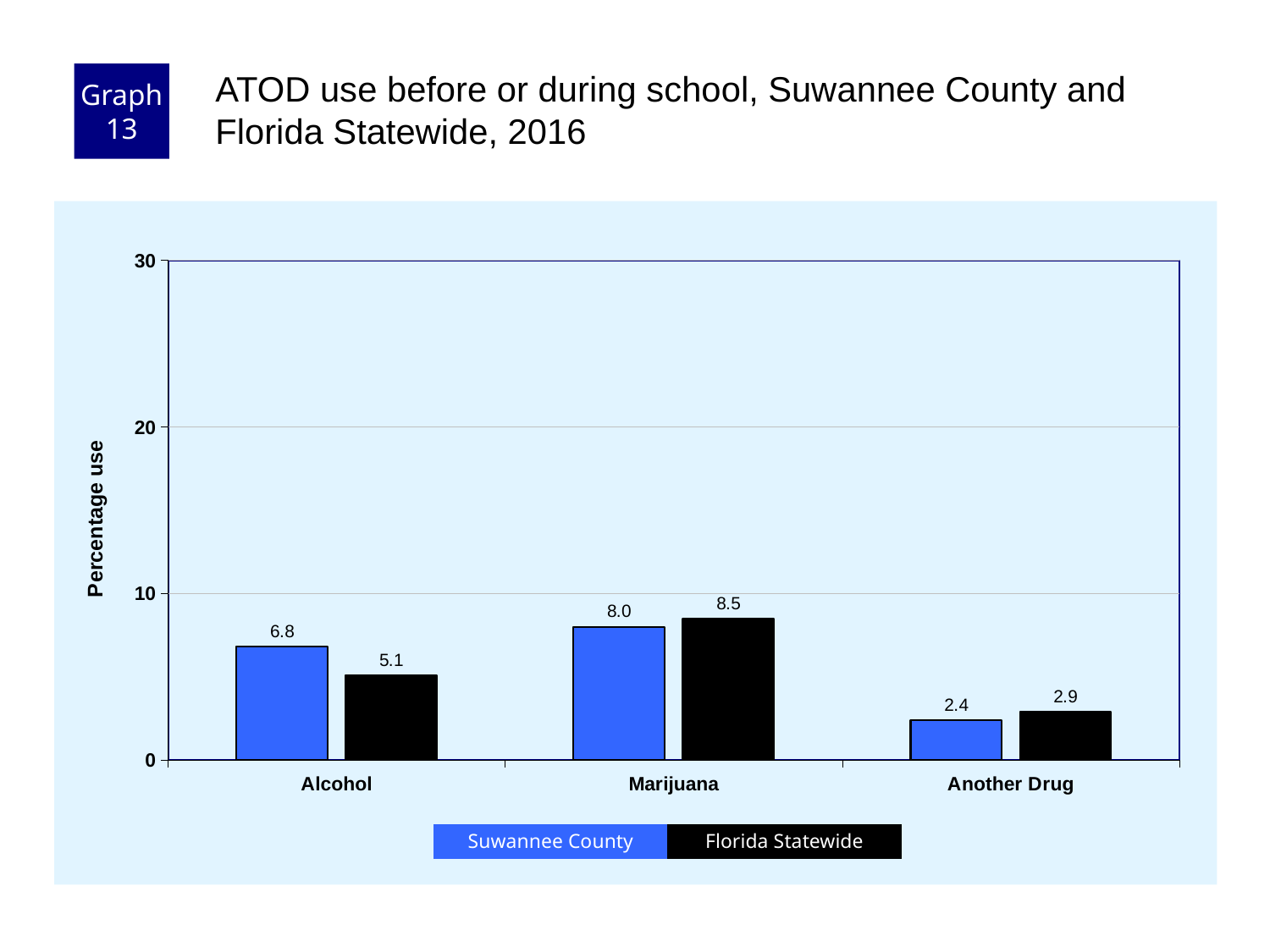
What is the label of the y axis? Percentage use Which category has the highest Florida Statewide value? Marijuana What is the Florida Statewide value for Marijuana? 8.5 How many categories are shown on the x axis? 3 Which category has the lowest Suwannee County value? Another Drug What is the difference between the Suwannee County and Florida Statewide values for Alcohol? 1.7 How many series does the legend list? 2 Which is larger for Marijuana, Suwannee County or Florida Statewide? Florida Statewide What is the Suwannee County value for Alcohol? 6.8 What is the Suwannee County value for Another Drug? 2.4 What kind of chart is shown on the slide? bar chart Is the Florida Statewide value for Alcohol greater or less than 10? less